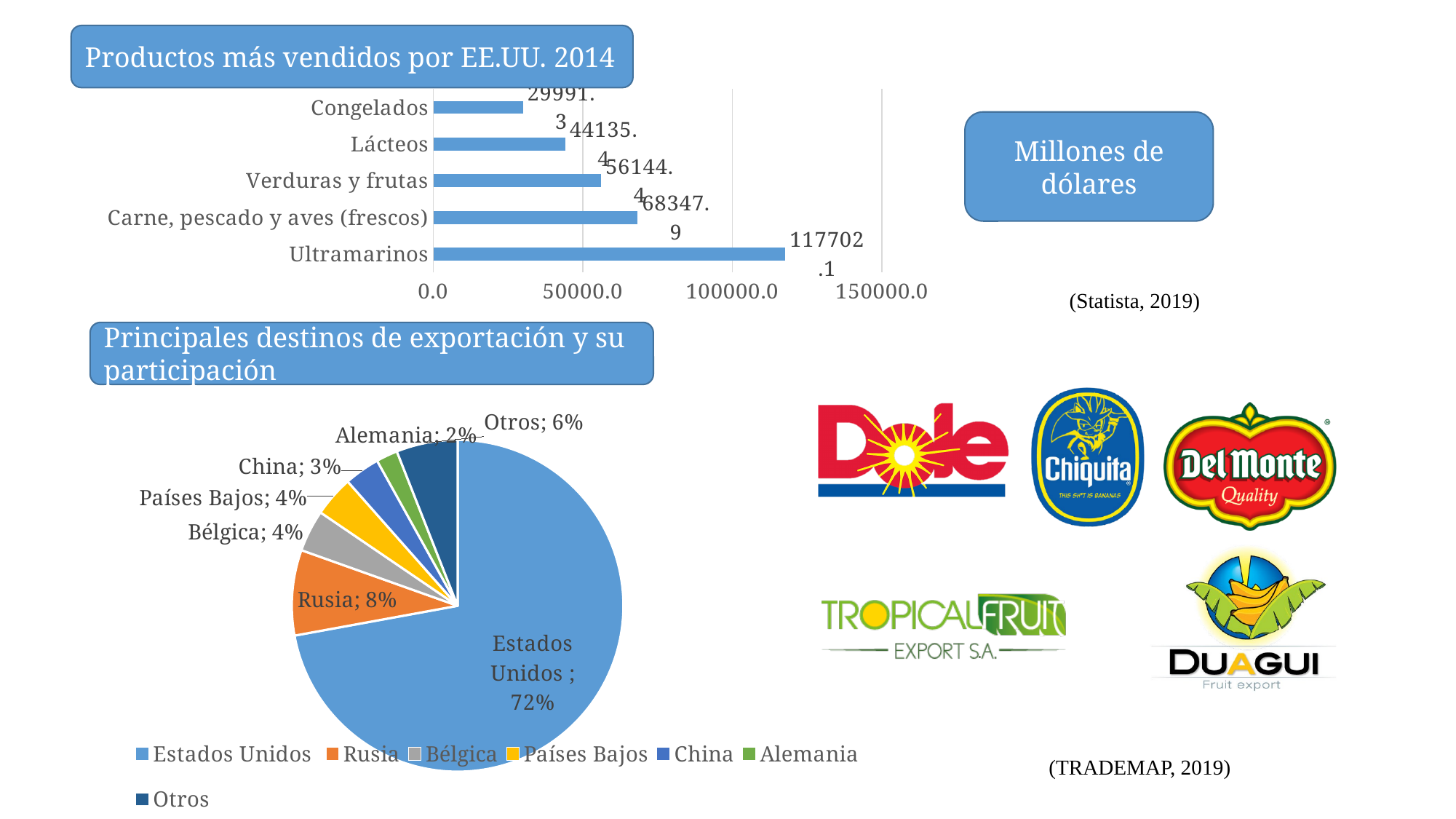
In the bar chart 'Productos más vendidos por EE.UU. 2014', what is the difference between Carne, pescado y aves (frescos) and Verduras y frutas? 12203.5 In the bar chart 'Productos más vendidos por EE.UU. 2014', how many categories are shown? 5 In the pie chart 'Principales destinos de exportación y su participación', what share does Rusia have? 8% In the pie chart 'Principales destinos de exportación y su participación', which destination has the smallest share? Alemania In the bar chart 'Productos más vendidos por EE.UU. 2014', which category has the highest value? Ultramarinos In the pie chart 'Principales destinos de exportación y su participación', how many entries does the legend list? 7 In the bar chart 'Productos más vendidos por EE.UU. 2014', what is the value for Ultramarinos? 117702.1 What type of chart is 'Productos más vendidos por EE.UU. 2014'? Bar chart In the pie chart 'Principales destinos de exportación y su participación', what share does Estados Unidos have? 72% In the pie chart 'Principales destinos de exportación y su participación', which is larger, the share for China or the share for Otros? Otros In the bar chart 'Productos más vendidos por EE.UU. 2014', what is the value for Lácteos? 44135.4 In the bar chart 'Productos más vendidos por EE.UU. 2014', which category has the lowest value? Congelados